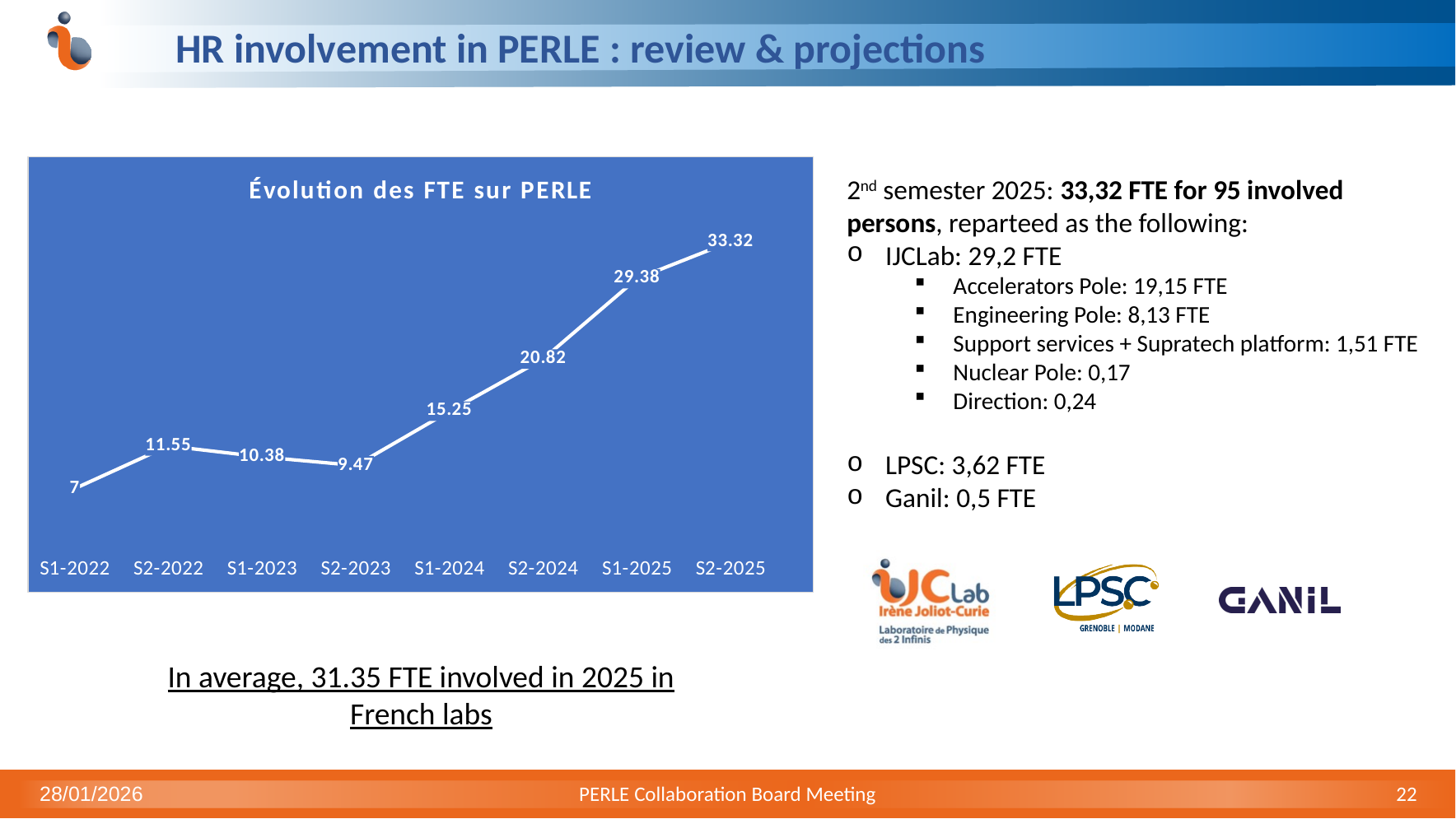
How many periods are plotted on the x axis? 8 What is the value for S1-2022? 7 What is the difference between the values for S2-2025 and S1-2025? 3.94 Which period has the lowest value? S1-2022 Which period has the highest value? S2-2025 What is the value for S1-2024? 15.25 What is the value for S2-2025? 33.32 Which is larger, the value for S2-2022 or the value for S1-2023? S2-2022 Do the values rise or fall from S2-2023 to S2-2025? Rise What is the title of the chart? Évolution des FTE sur PERLE What kind of chart is shown? Line chart What is the value for S2-2023? 9.47